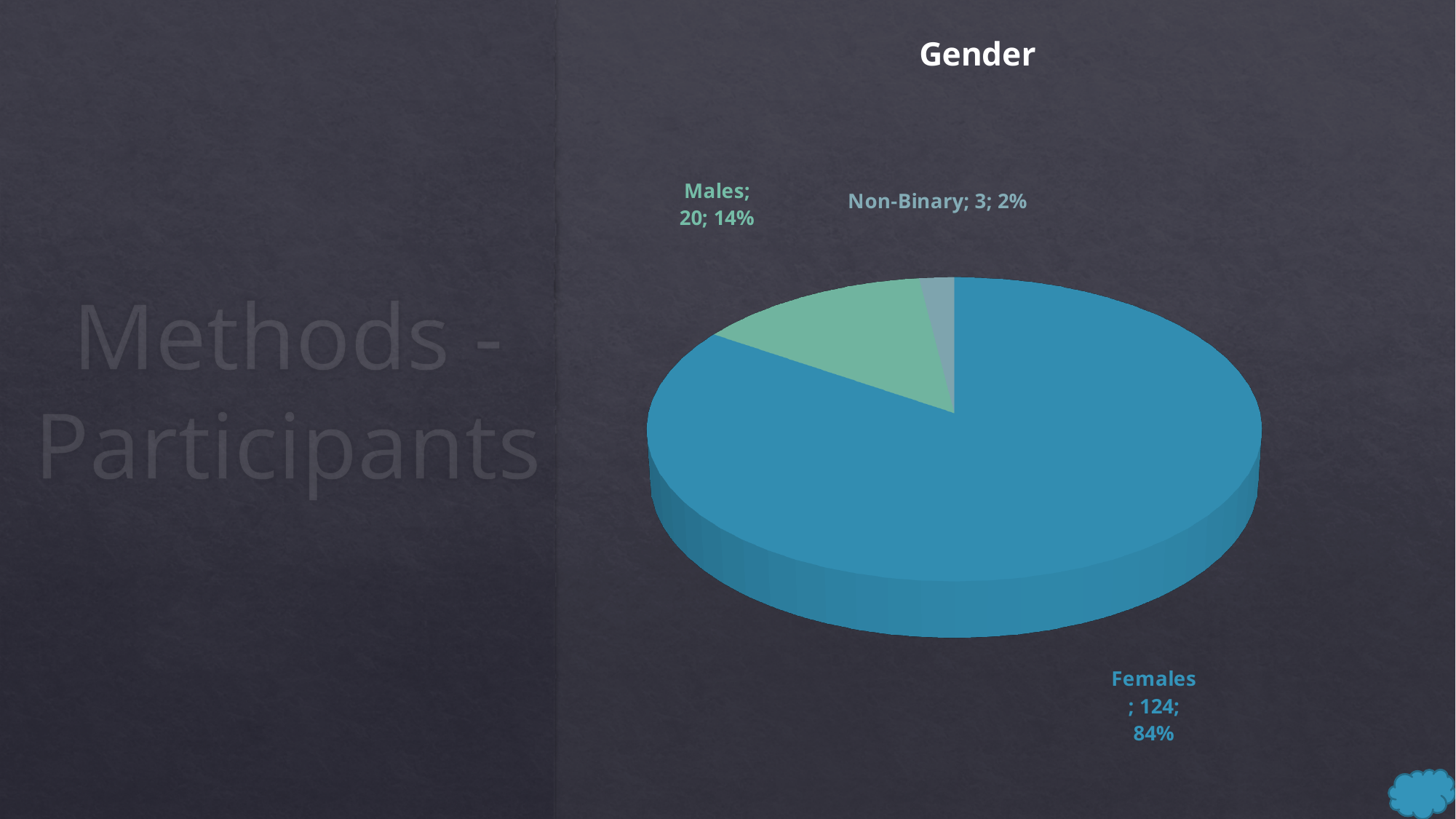
What is the title of the chart? Gender Which category has the largest slice? Females What is the value for Females? 124 How many slices does the pie chart have? 3 What kind of chart is shown on the slide? pie chart What share of the pie does the Males slice represent? 14% Which category has the smallest slice? Non-Binary What share of the pie does the Females slice represent? 84% What is the difference between the values for Females and Males? 104 What is the value for Males? 20 What is the value for Non-Binary? 3 Which is larger, the value for Males or the value for Non-Binary? Males